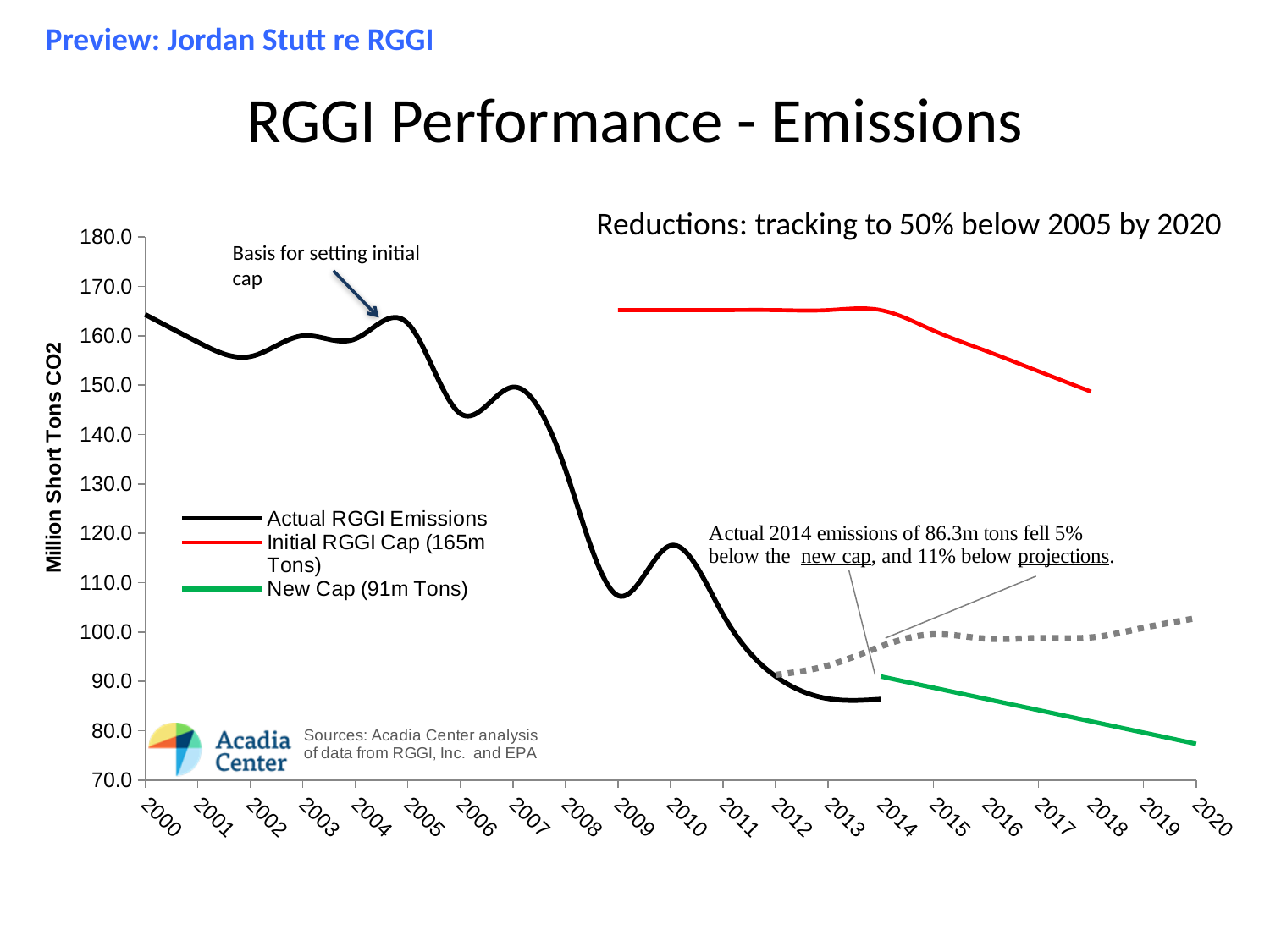
How many series does the chart's legend list? 3 How many years are labelled along the x axis of the chart? 21 Do Actual RGGI Emissions generally rise or fall from 2000 to 2014? fall Is the value of Actual RGGI Emissions in 2000 greater or less than 160? greater What kind of chart is shown on the slide? line chart What is the title of the chart on the slide? RGGI Performance - Emissions Is the value of Actual RGGI Emissions in 2012 greater or less than 100? less In 2014, which is larger: Actual RGGI Emissions or the New Cap? New Cap What level is the New Cap series set at, according to the legend? 91m Tons What is the label on the chart's vertical axis? Million Short Tons CO2 What level is the Initial RGGI Cap series set at, according to the legend? 165m Tons According to the annotation on the chart, what were actual RGGI emissions in 2014? 86.3m tons